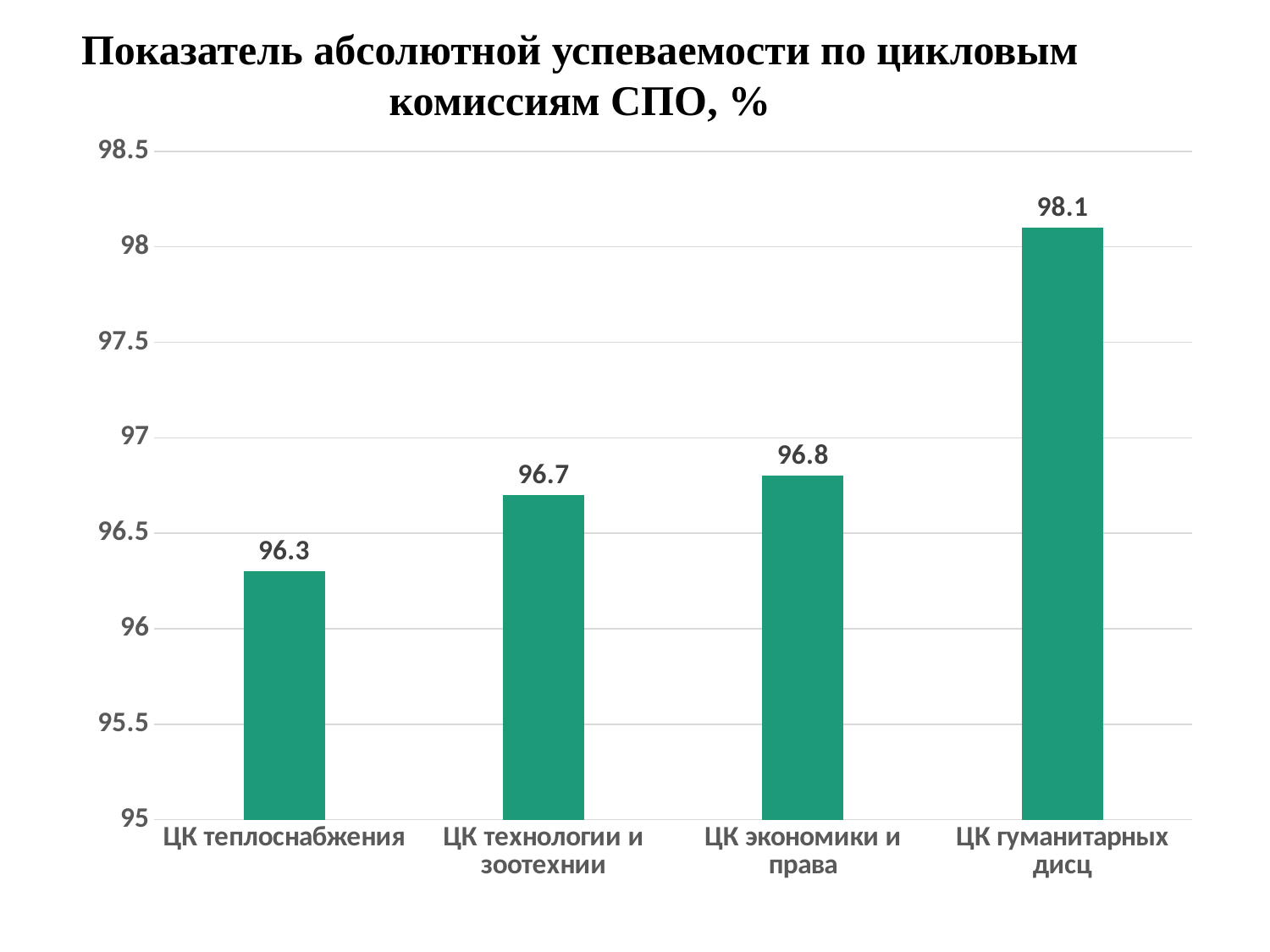
Which category has the highest value? ЦК гуманитарных дисц What kind of chart is shown on the slide? bar chart Which is larger, the value for ЦК гуманитарных дисц or the value for ЦК экономики и права? ЦК гуманитарных дисц Which category has the lowest value? ЦК теплоснабжения What is the value for ЦК теплоснабжения? 96.3 What is the difference between the values for ЦК гуманитарных дисц and ЦК теплоснабжения? 1.8 What is the difference between the values for ЦК экономики и права and ЦК технологии и зоотехнии? 0.1 What is the value for ЦК экономики и права? 96.8 Is the value for ЦК гуманитарных дисц greater or less than 98? greater How many categories are shown in the chart? 4 What is the value for ЦК технологии и зоотехнии? 96.7 What is the value for ЦК гуманитарных дисц? 98.1